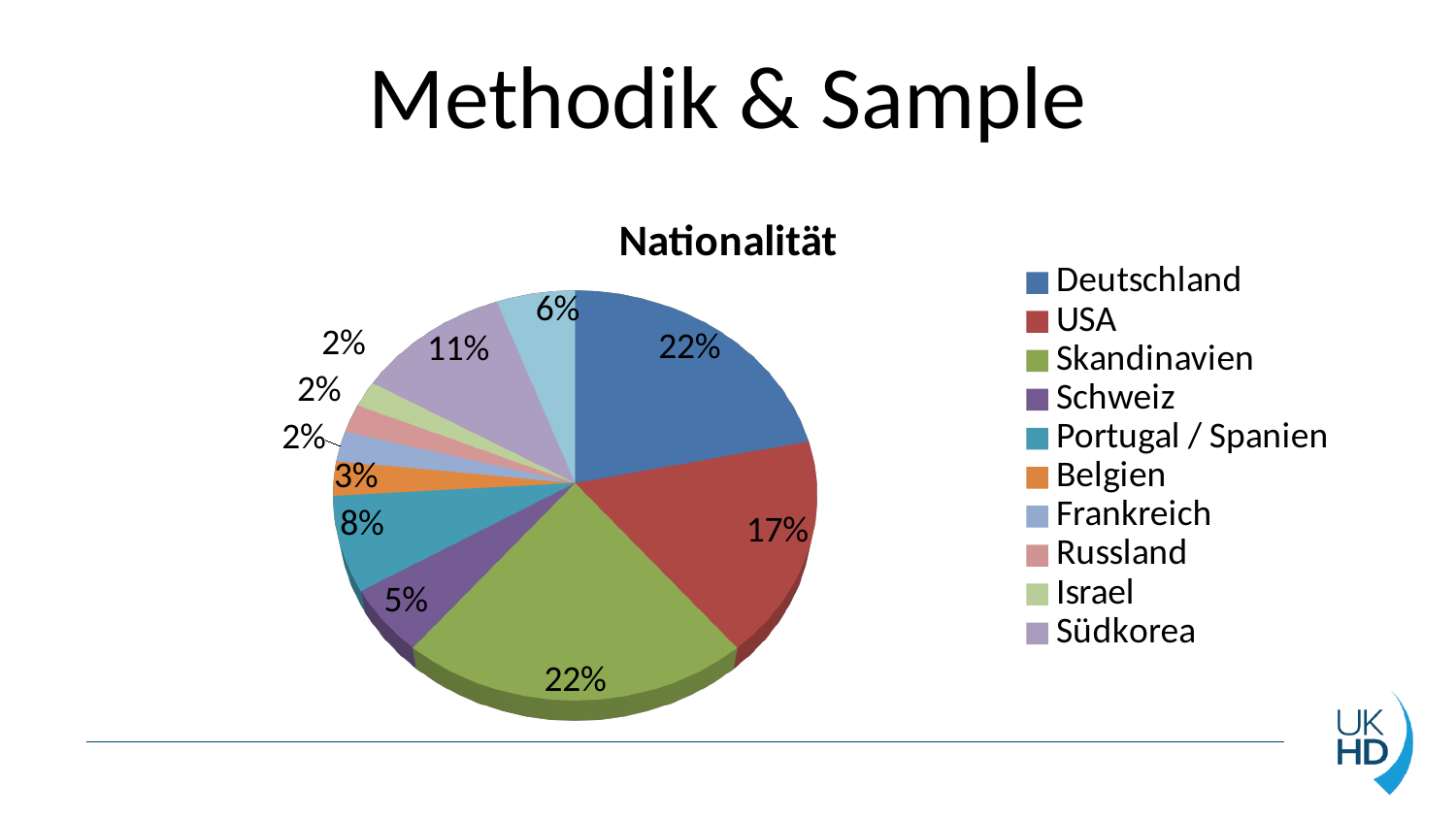
What share of the pie does USA have? 17% What share of the pie does Frankreich have? 2% What share of the pie does Südkorea have? 11% What share of the pie does Portugal / Spanien have? 8% How many entries does the legend list? 10 What share of the pie does Belgien have? 3% What share of the pie does Schweiz have? 5% What kind of chart is shown on the slide? pie chart Which has the larger share, USA or Südkorea? USA What is the title of the chart? Nationalität What share of the pie does Deutschland have? 22% How many percentage points larger is the share of Deutschland than the share of USA? 5%